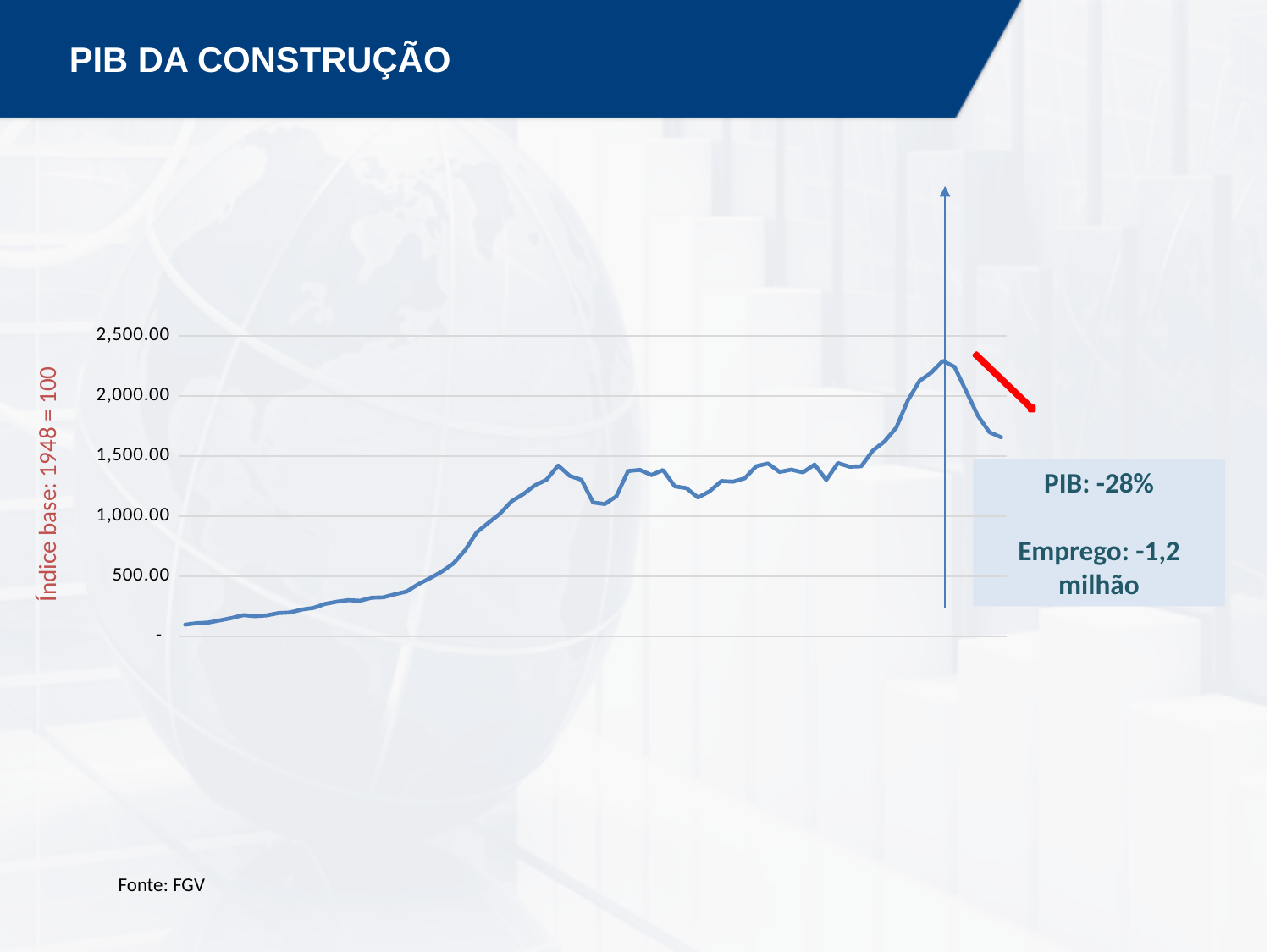
What is the title of the slide containing the chart? PIB DA CONSTRUÇÃO Is the value at the left end of the line greater or less than 500.00? less What kind of chart is shown on the slide? line chart Is the value at the right end of the line greater or less than 2,000.00? less Is the peak value of the line greater or less than 2,000.00? greater What is the highest value shown on the vertical axis of the chart? 2,500.00 How many lines are plotted on the chart? 1 Does the line generally rise or fall from the left end of the chart to its peak? rise After the peak marked by the vertical arrow, does the line rise or fall? fall What is the label on the vertical axis of the chart? Índice base: 1948 = 100